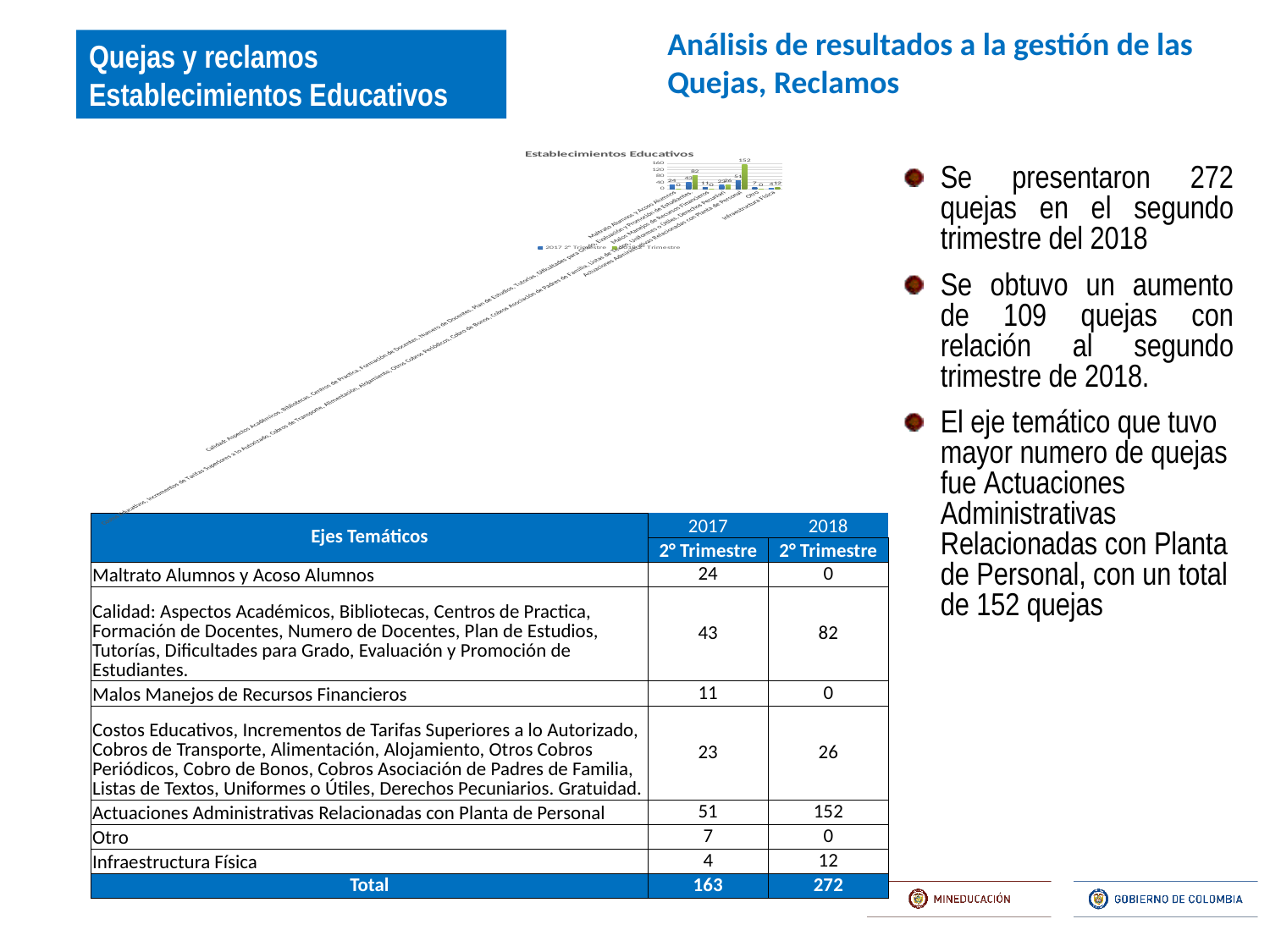
Is the 2018 2° Trimestre value for Actuaciones Administrativas Relacionadas con Planta de Personal greater or less than 120? greater What is the difference between the 2018 and 2017 2° Trimestre values for Actuaciones Administrativas Relacionadas con Planta de Personal? 101 What is the title of the chart? Establecimientos Educativos What type of chart is shown on the slide? bar chart What is the value for Maltrato Alumnos y Acoso Alumnos in the 2017 2° Trimestre series? 24 What is the value for Otro in the 2017 2° Trimestre series? 7 How many categories are plotted along the x axis of the chart? 7 Which category has the tallest bar in the chart? Actuaciones Administrativas Relacionadas con Planta de Personal How many series does the chart's legend list? 2 What is the value for Infraestructura Física in the 2018 2° Trimestre series? 12 Which is larger for Infraestructura Física: the 2017 2° Trimestre value or the 2018 2° Trimestre value? 2018 2° Trimestre What is the highest data label shown on the chart? 152